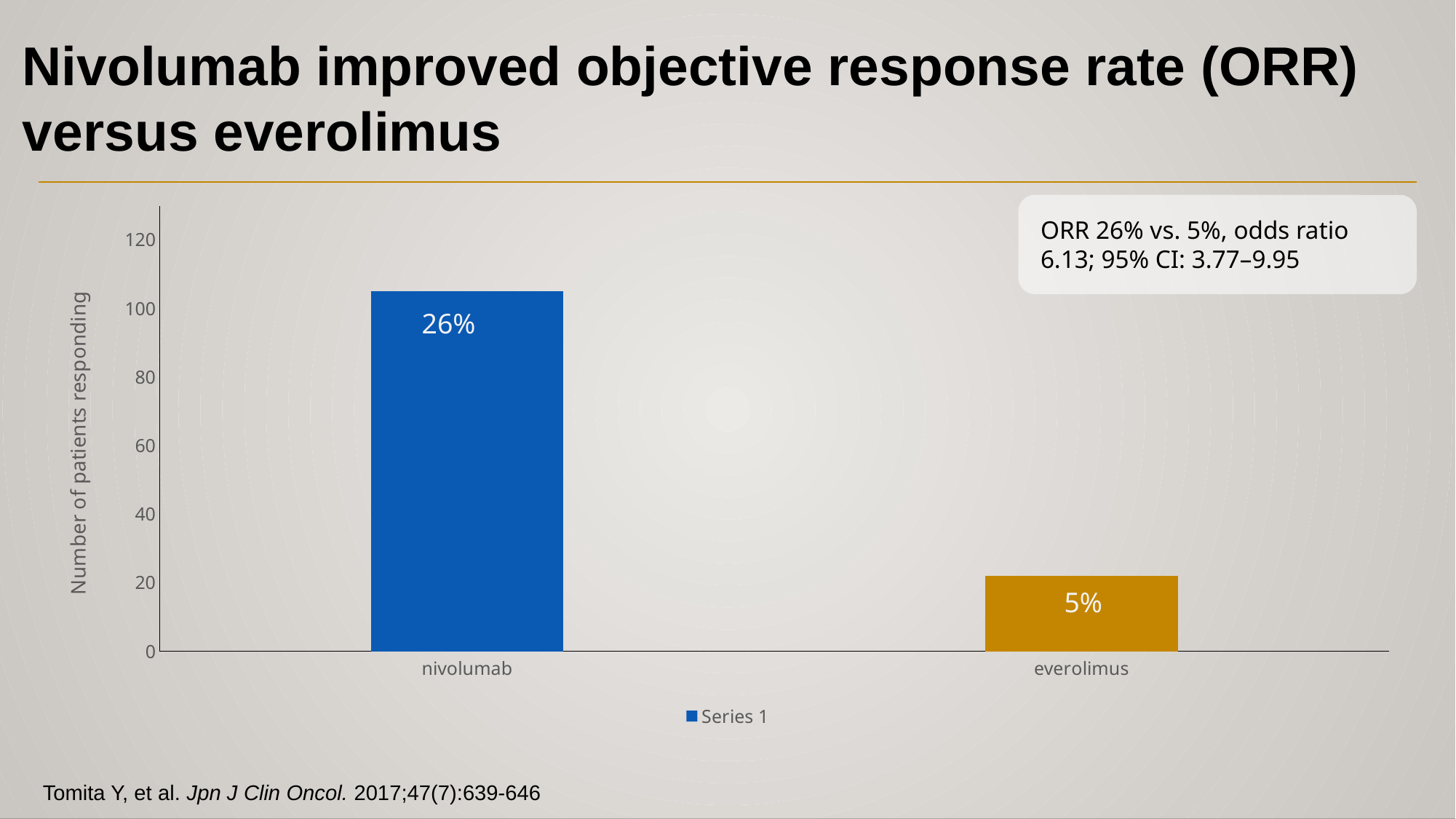
What data label is shown on the everolimus bar? 5% What is the label of the y axis? Number of patients responding What data label is shown on the nivolumab bar? 26% By how many percentage points does the labelled ORR for nivolumab exceed that for everolimus? 21 percentage points Which category has the taller bar? nivolumab Which category has the shorter bar? everolimus What kind of chart is shown on the slide? bar chart Is the value for nivolumab greater or less than 100 on the y axis? greater How many categories are shown on the x axis? 2 How many series does the legend list? 1 Is the value for everolimus greater or less than 40 on the y axis? less Is the bar for nivolumab taller or shorter than the bar for everolimus? taller